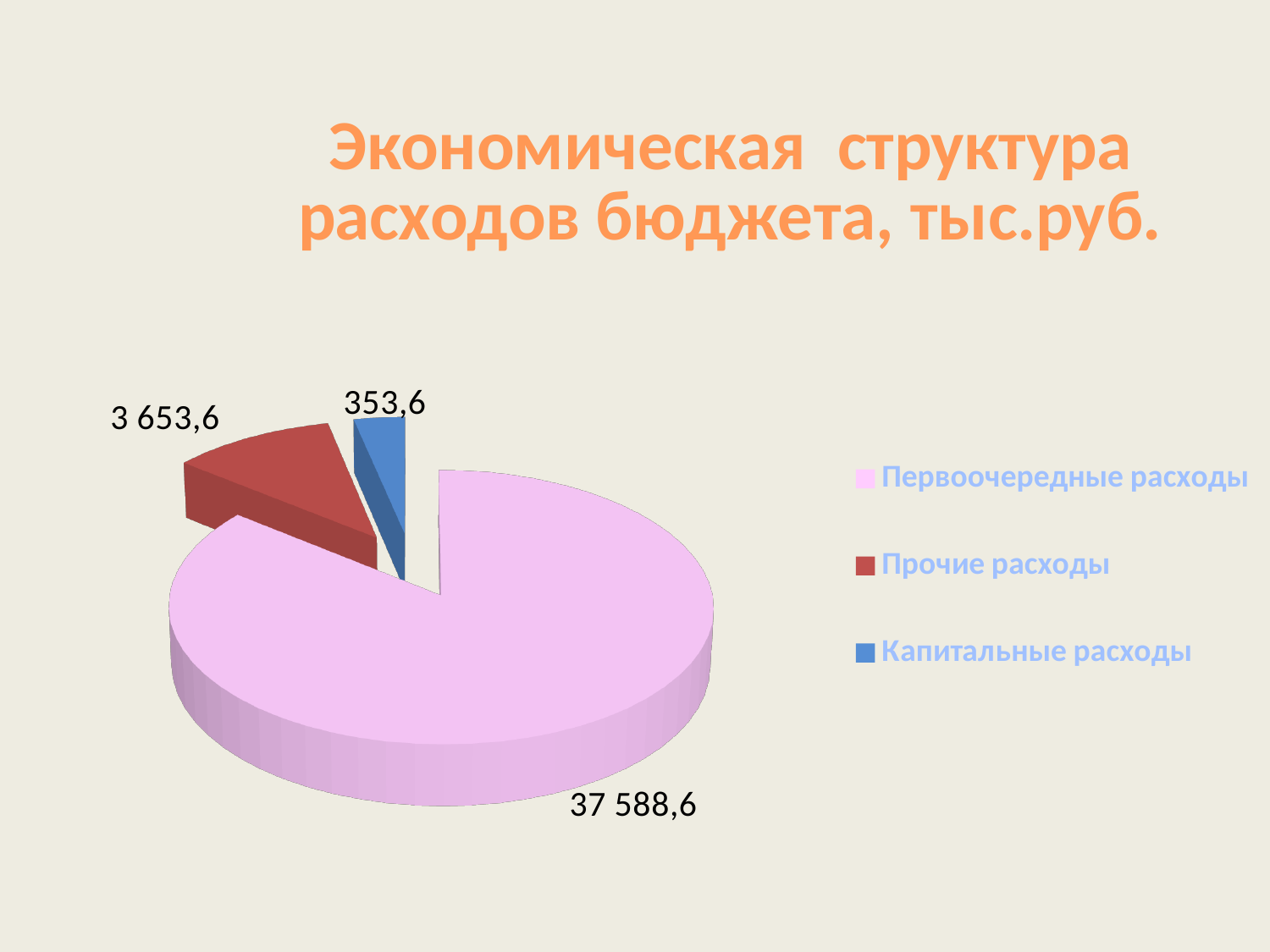
Which category has the smallest slice of the pie? Капитальные расходы What is the value for Прочие расходы? 3 653,6 What is the title of the chart? Экономическая структура расходов бюджета, тыс.руб. What is the total of all three slices in the pie chart? 41 595,8 What type of chart is shown on the slide? Pie chart How many categories are shown in the pie chart? 3 Which category has the largest slice of the pie? Первоочередные расходы What is the difference between Первоочередные расходы and Прочие расходы? 33 935,0 What is the value for Первоочередные расходы? 37 588,6 Which is larger, Прочие расходы or Капитальные расходы? Прочие расходы What is the difference between Прочие расходы and Капитальные расходы? 3 300,0 What is the value for Капитальные расходы? 353,6